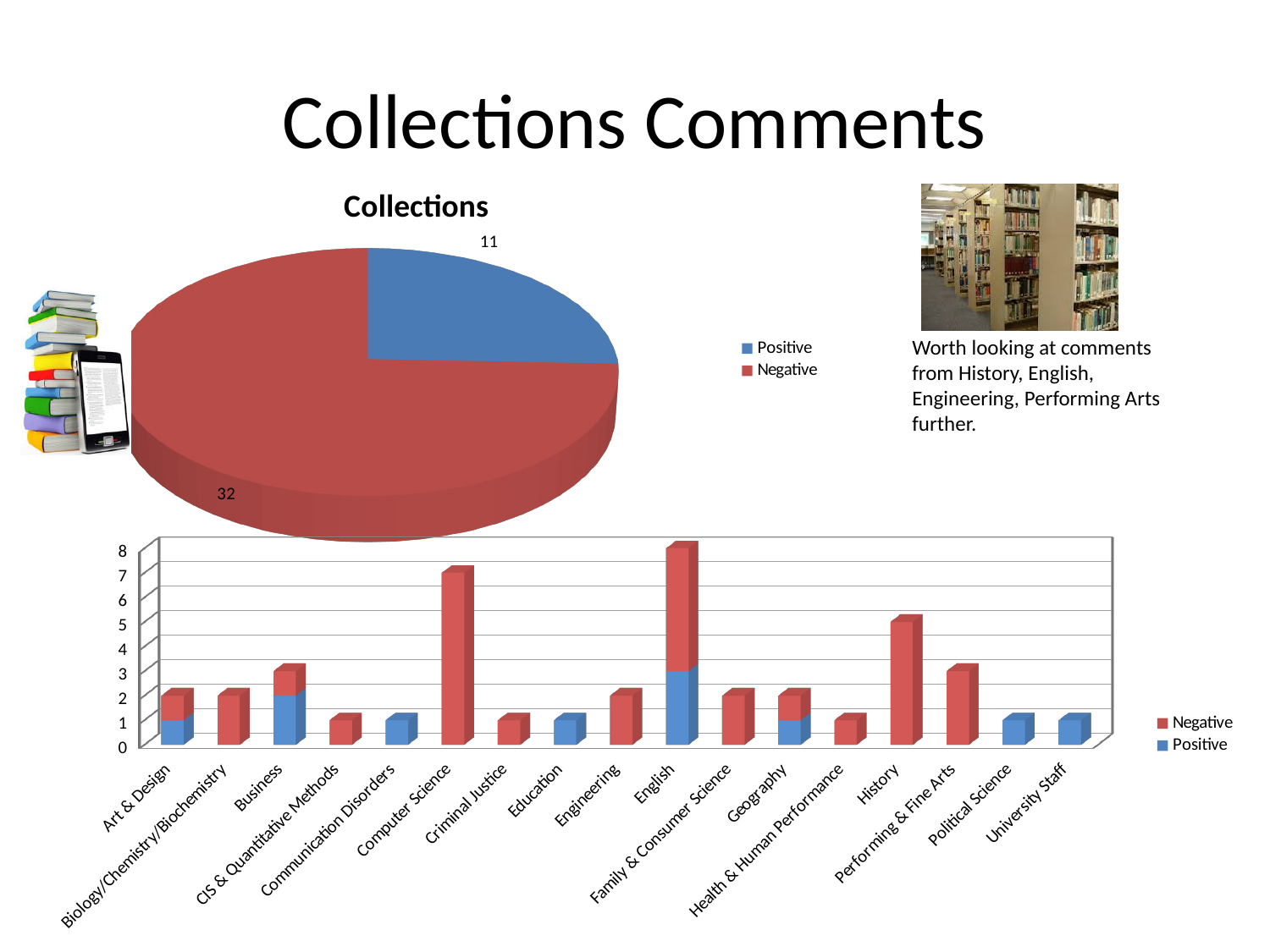
In the bar chart at the bottom of the slide, which category has the tallest stacked bar? English How many categories are shown on the x axis of the bar chart at the bottom of the slide? 17 In the pie chart titled Collections, what is the value for Negative? 32 How many entries does the legend of the pie chart titled Collections list? 2 In the pie chart titled Collections, which slice is larger, Positive or Negative? Negative In the bar chart at the bottom of the slide, what is the total height of the stacked bar for Computer Science? 7 In the bar chart at the bottom of the slide, is the value for History greater or less than 4? greater In the bar chart at the bottom of the slide, which series is shown in red? Negative In the pie chart titled Collections, what is the difference between the Negative and Positive values? 21 In the bar chart at the bottom of the slide, what is the total height of the stacked bar for English? 8 What kind of chart is the chart at the bottom of the slide? bar chart In the pie chart titled Collections, what is the value for Positive? 11